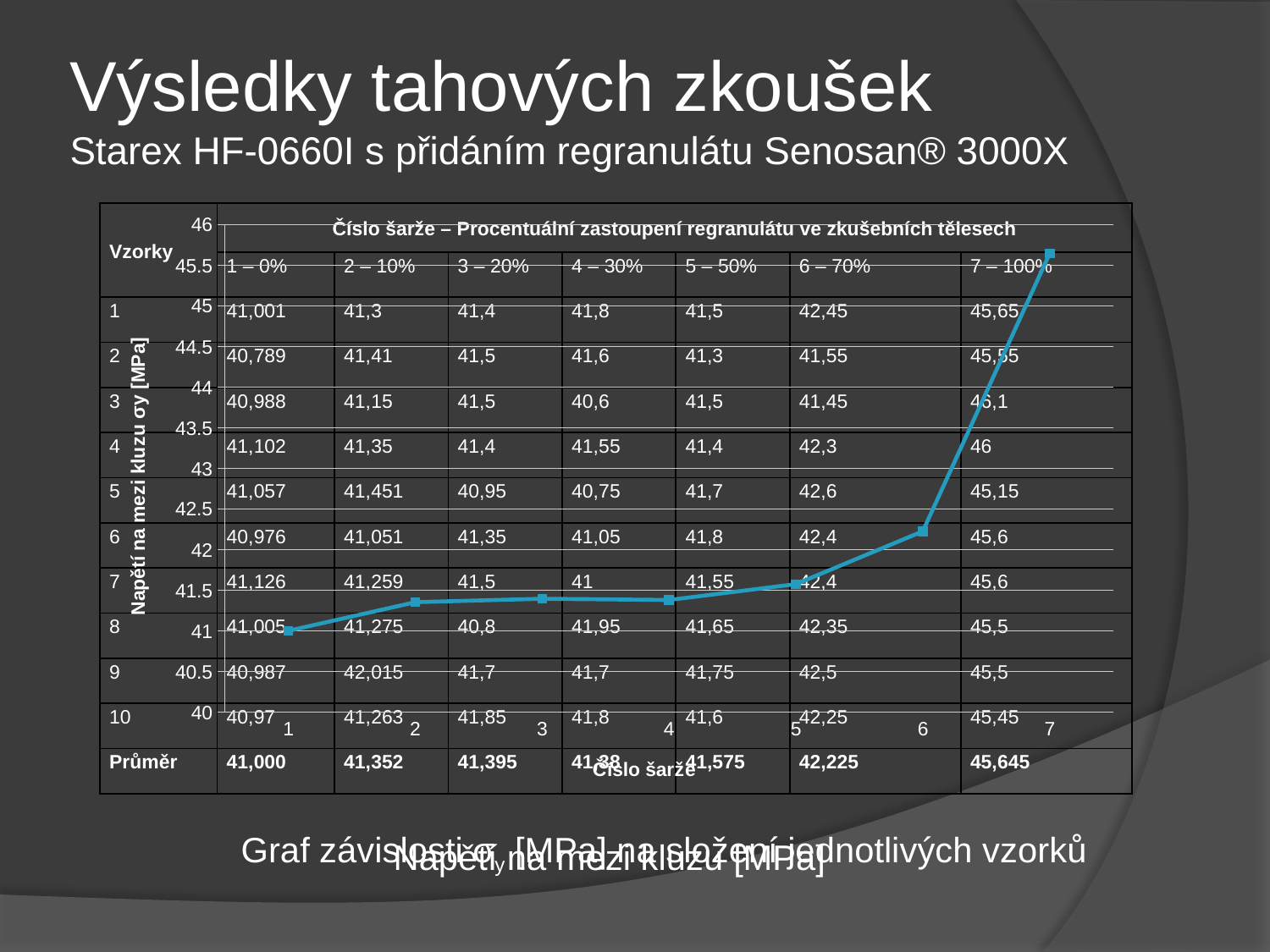
Which batch number (Číslo šarže) has the highest value on the chart? 7 How many data points are plotted on the line chart? 7 What is the label of the x axis of the chart? Číslo šarže Is the value for batch 7 greater or less than 45? greater Is the value for batch 6 greater or less than 42? greater Do the values on the chart generally rise or fall as the batch number increases from 1 to 7? rise Is the value for batch 5 greater or less than 42? less Which has the larger value on the chart, batch 6 or batch 5? batch 6 What kind of chart is shown on the slide? line chart Which batch number (Číslo šarže) has the lowest value on the chart? 1